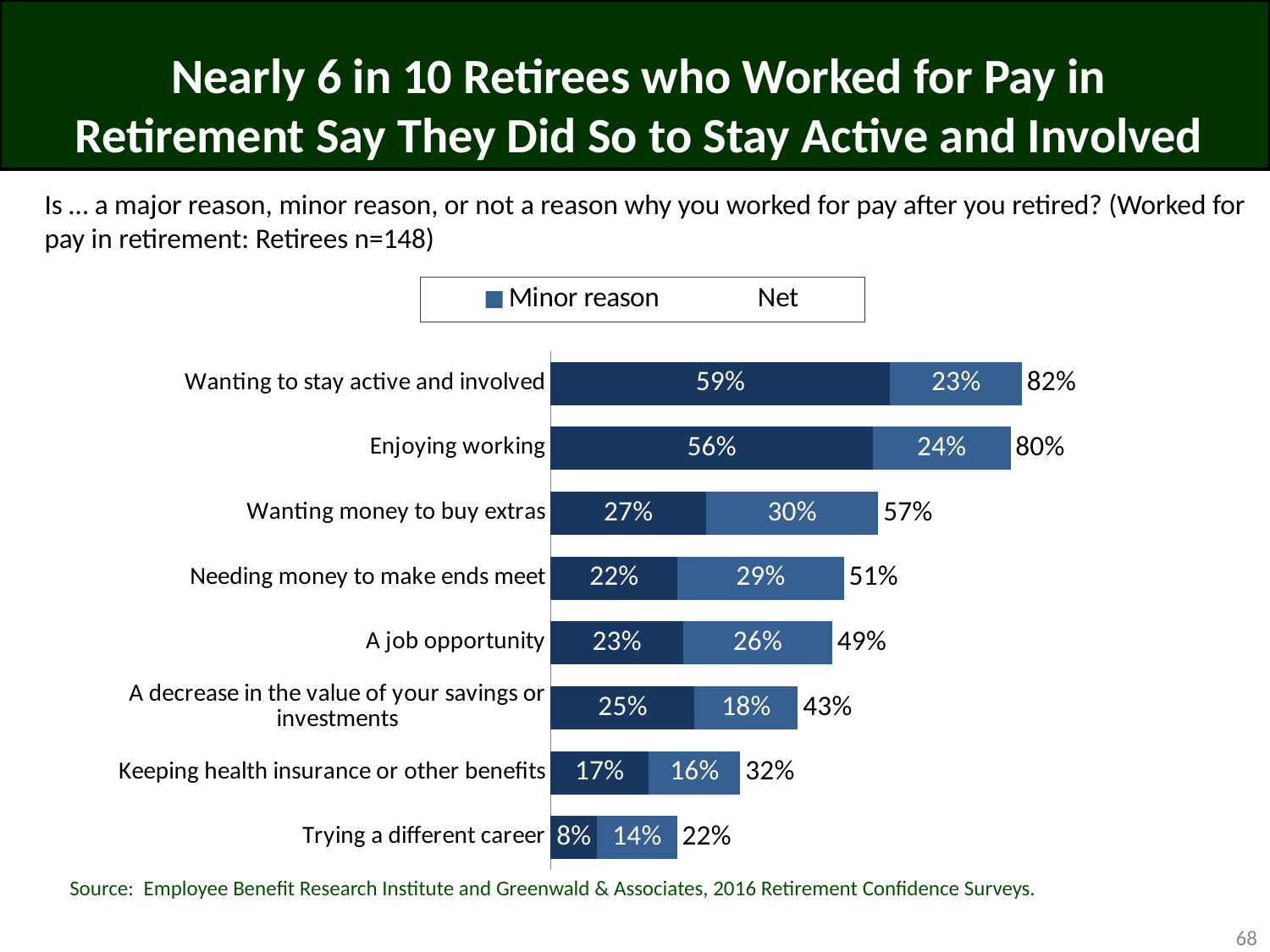
Which category has the lowest Net value? Trying a different career Which has a larger Minor reason value, "Needing money to make ends meet" or "A job opportunity"? Needing money to make ends meet What kind of chart is shown on the slide? Stacked bar chart What is the value of the dark blue segment for "A decrease in the value of your savings or investments"? 25% Which category has the highest Net value? Wanting to stay active and involved What is the total of the two segments in the bar for "Keeping health insurance or other benefits"? 33% What is the Net value for "Wanting to stay active and involved"? 82% What is the difference between the Net values for "Wanting to stay active and involved" and "Enjoying working"? 2% What is the Net value for "Trying a different career"? 22% How many categories are shown in the chart? 8 What is the Minor reason value for "Enjoying working"? 24% What is the Minor reason value for "Wanting money to buy extras"? 30%